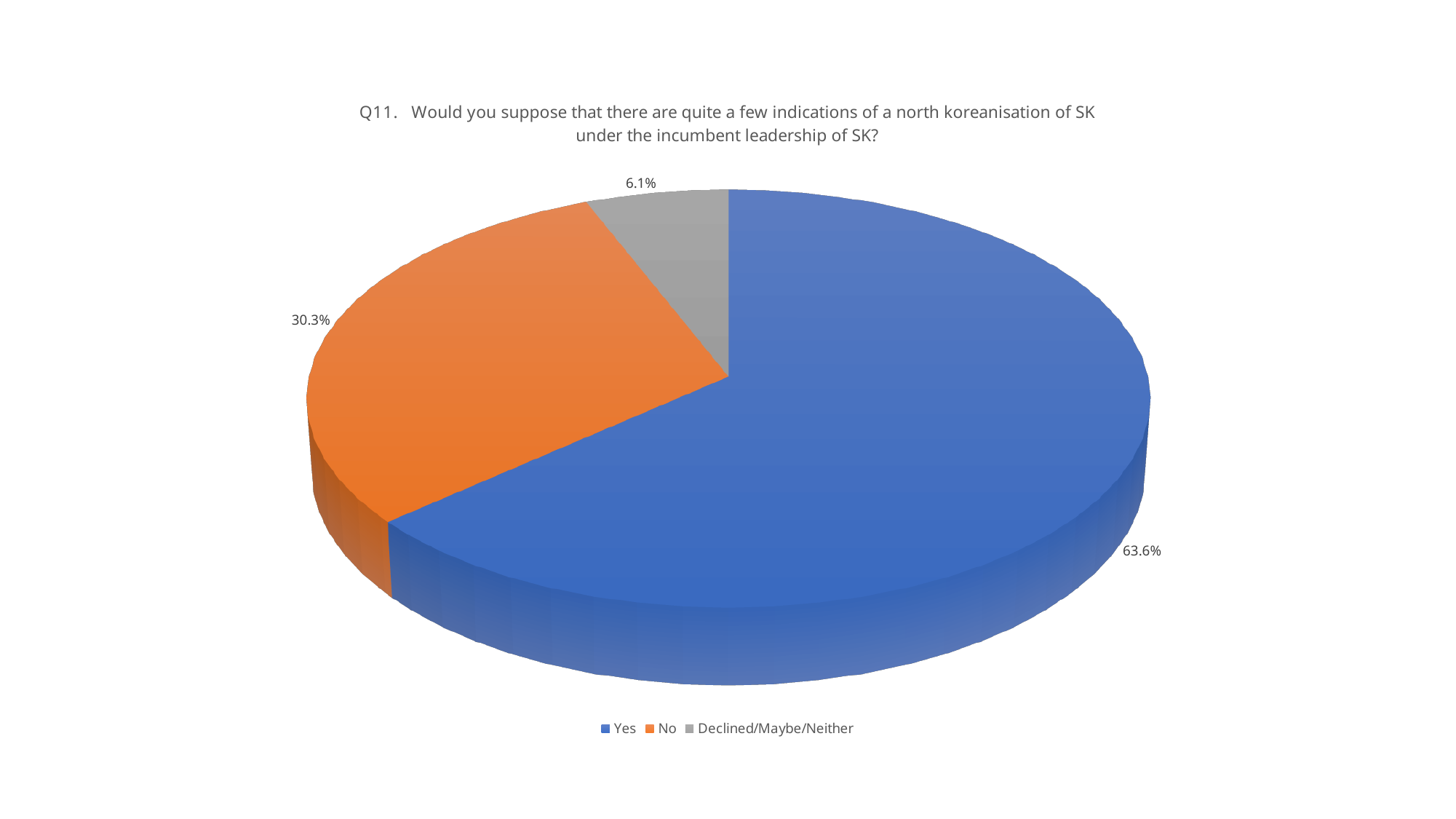
What is the question number shown in the chart title? Q11 Which response has the largest share of the pie? Yes Which response has the smallest share of the pie? Declined/Maybe/Neither What share of respondents answered No? 30.3% What share of respondents are in the Declined/Maybe/Neither category? 6.1% What is the difference in percentage points between the No and Declined/Maybe/Neither shares? 24.2 How many categories does the pie chart show? 3 What colour is the Yes slice? Blue Which is larger, the share for No or the share for Declined/Maybe/Neither? No What share of respondents answered Yes? 63.6% What is the difference in percentage points between the Yes and No shares? 33.3 What kind of chart is shown on the slide? Pie chart